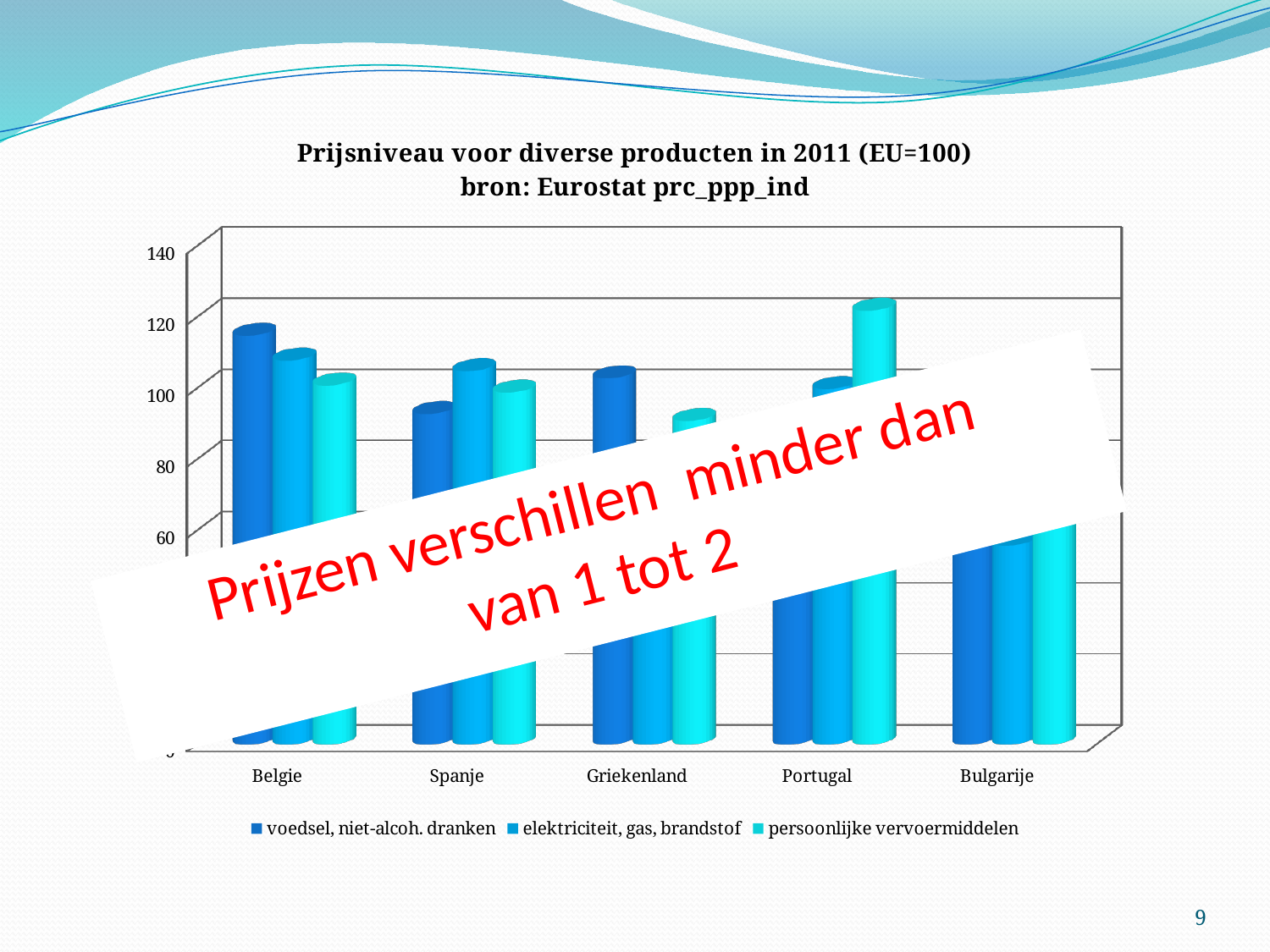
How many countries are shown on the x axis of the chart? 5 Which series is shown in the darkest blue in the legend? voedsel, niet-alcoh. dranken For Belgie, which series has the highest value? voedsel, niet-alcoh. dranken Which is larger: the value for voedsel, niet-alcoh. dranken in Belgie or in Spanje? Belgie What kind of chart is shown on the slide? bar chart For Spanje, which series has the lowest value? voedsel, niet-alcoh. dranken How many series does the chart's legend list? 3 Is the value for voedsel, niet-alcoh. dranken in Spanje greater or less than 100? less Is the value for persoonlijke vervoermiddelen in Portugal greater or less than 100? greater Is the value for persoonlijke vervoermiddelen in Griekenland greater or less than 100? less What is the first line of the chart's title? Prijsniveau voor diverse producten in 2011 (EU=100)